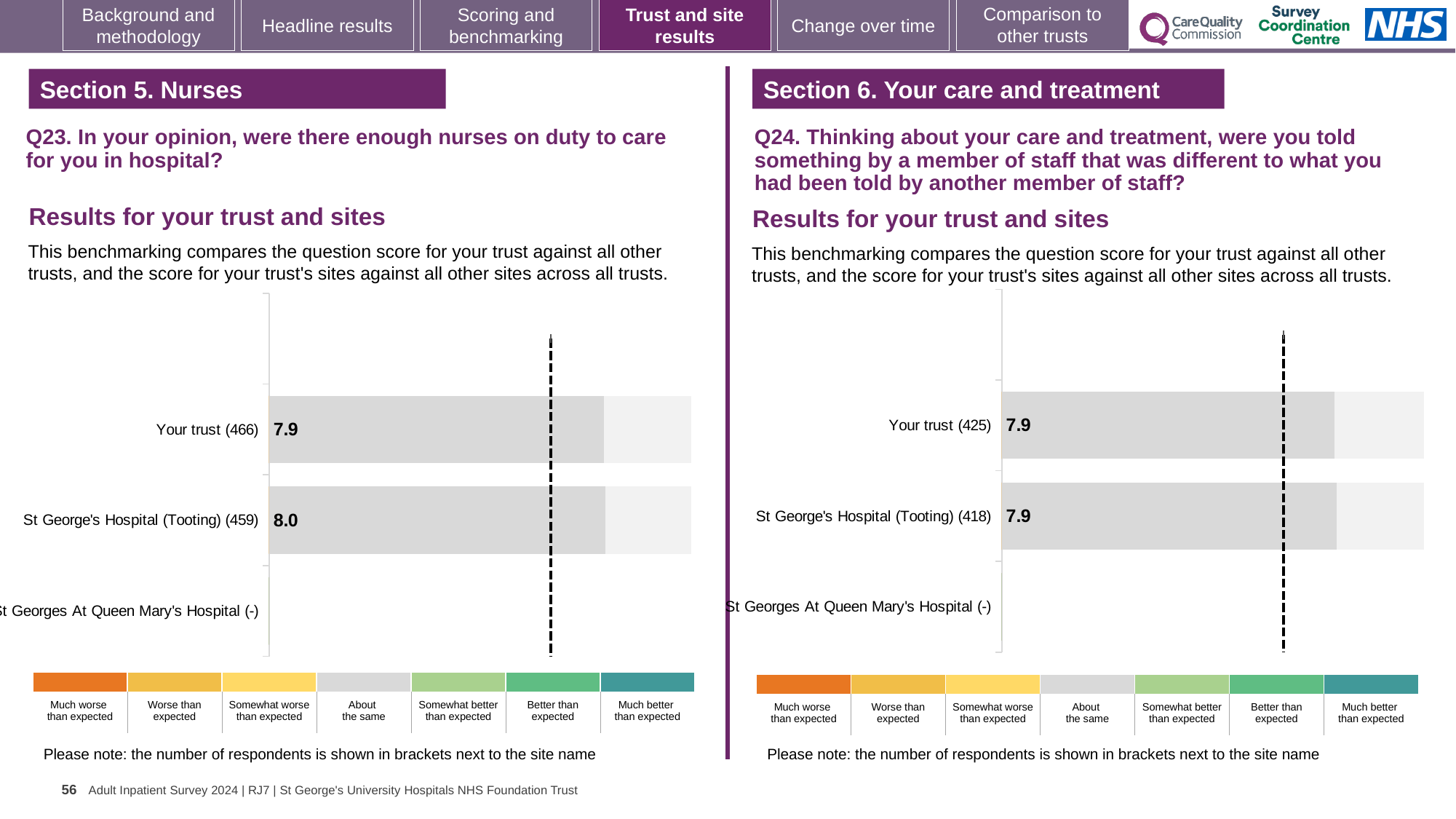
In the Q24 chart on the right, how many respondents are shown in brackets for Your trust? 425 In the Q23 chart on the left, what is the difference between the score for St George's Hospital (Tooting) (459) and the score for Your trust (466)? 0.1 In the Q24 chart on the right, what is the score for Your trust (425)? 7.9 In the Q24 chart on the right, what is the score for St George's Hospital (Tooting) (418)? 7.9 In the Q23 chart on the left, which is larger: the score for Your trust (466) or the score for St George's Hospital (Tooting) (459)? St George's Hospital (Tooting) (459) How many rating categories does the colour legend below the Q23 chart on the left list? 7 In the Q23 chart on the left, which labelled site or trust has the highest score? St George's Hospital (Tooting) (459) In the Q23 chart on the left, what is the score for St George's Hospital (Tooting) (459)? 8.0 In the legend below the Q24 chart on the right, which rating category is shown in orange at the far left? Much worse than expected How many categories are listed on the vertical axis of the Q24 chart on the right? 3 In the Q23 chart on the left, what is the score for Your trust (466)? 7.9 What kind of chart is used for the Q23 results on the left? Bar chart